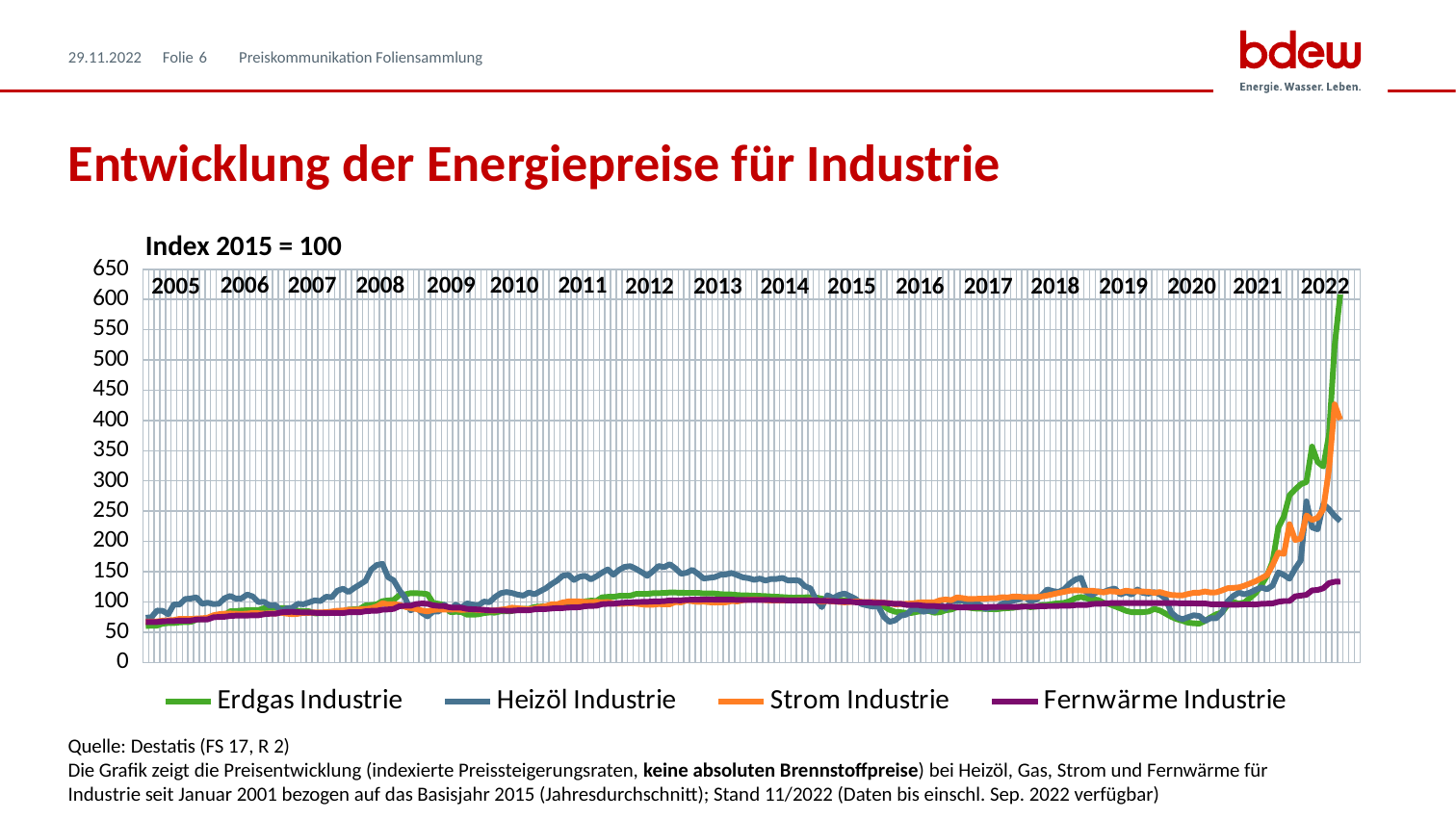
Which colour is used for the Erdgas Industrie line? green Does the Erdgas Industrie line rise or fall from 2021 to 2022? rise At the end of 2022, which is larger: Erdgas Industrie or Fernwärme Industrie? Erdgas Industrie How many series does the legend list? 4 Is the value for Strom Industrie at the end of 2022 greater or less than 350? greater What kind of chart is shown on the slide? line chart How many years are labelled along the x axis? 18 Which series reaches the highest value on the chart? Erdgas Industrie Which series has the lowest value at the end of 2022? Fernwärme Industrie Is the value for Fernwärme Industrie at the end of 2022 greater or less than 150? less What is the subtitle printed above the chart? Index 2015 = 100 Is the value for Erdgas Industrie at the end of 2022 greater or less than 500? greater